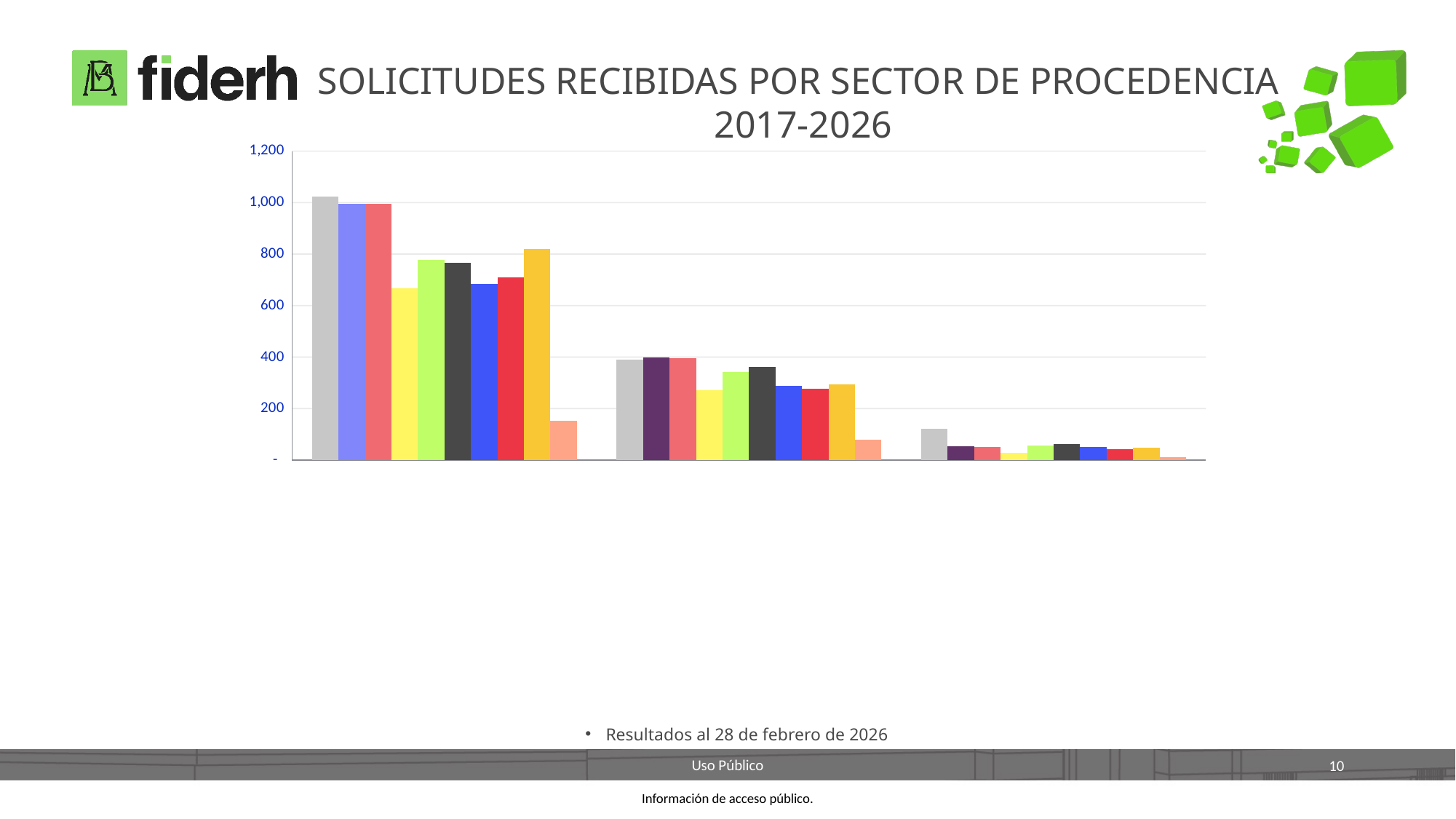
Is the value of the orange bar (ninth bar) in the leftmost group greater or less than 600? greater Is the value of the tallest bar in the middle group greater or less than 600? less Is the value of the first (grey) bar in the rightmost group greater or less than 200? less Which group of bars contains the tallest bars: the leftmost, middle, or rightmost? leftmost What kind of chart is shown on the slide? bar chart What is the highest value shown on the vertical axis? 1,200 Which group of bars contains the shortest bars: the leftmost, middle, or rightmost? rightmost What is the title of the chart on the slide? SOLICITUDES RECIBIDAS POR SECTOR DE PROCEDENCIA 2017-2026 How many bars are in each group of the chart? 10 How many groups of bars does the chart show? 3